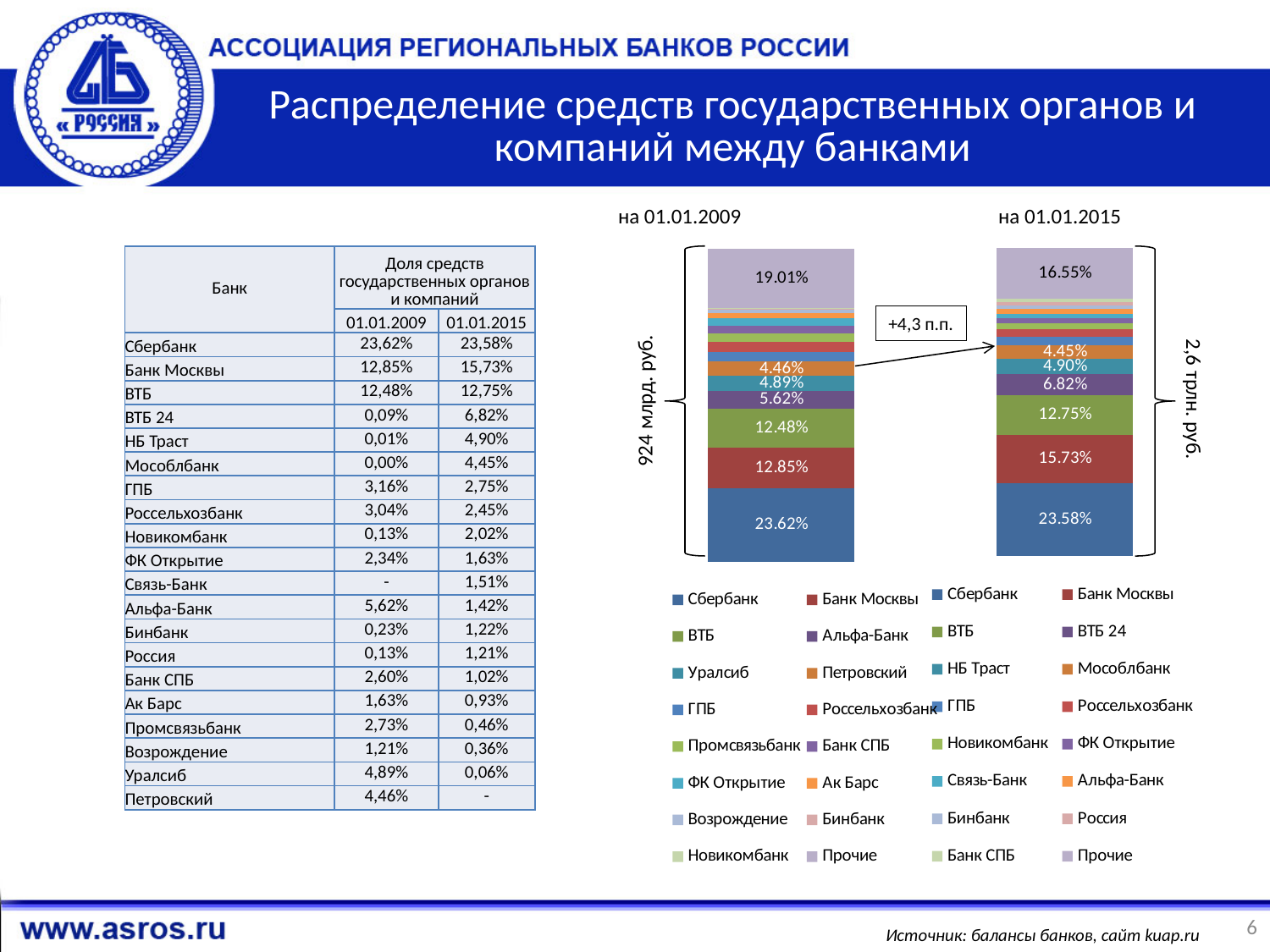
In the chart for 01.01.2015, what share is shown for Банк Москвы? 15.73% What change is shown by the arrow between the two charts? +4,3 п.п. How many entries does the legend of the chart for 01.01.2015 list? 16 In the chart for 01.01.2015, what share is shown for Прочие (the top segment)? 16.55% In the chart for 01.01.2015, what share is shown for ВТБ 24? 6.82% In the chart for 01.01.2009, which bank has the largest labelled segment? Сбербанк What total volume is indicated next to the chart for 01.01.2009? 924 млрд. руб. Which is larger in the chart for 01.01.2009: the share of ВТБ or the share of Банк Москвы? Банк Москвы In the chart for 01.01.2009, what share is shown for Сбербанк (the bottom segment)? 23.62% In the chart for 01.01.2015, what is the difference between the shares of Сбербанк and Банк Москвы? 7.85 percentage points What type of chart is used to show the distribution for 01.01.2009 and 01.01.2015? Stacked bar chart In the chart for 01.01.2009, what share is shown for Альфа-Банк? 5.62%